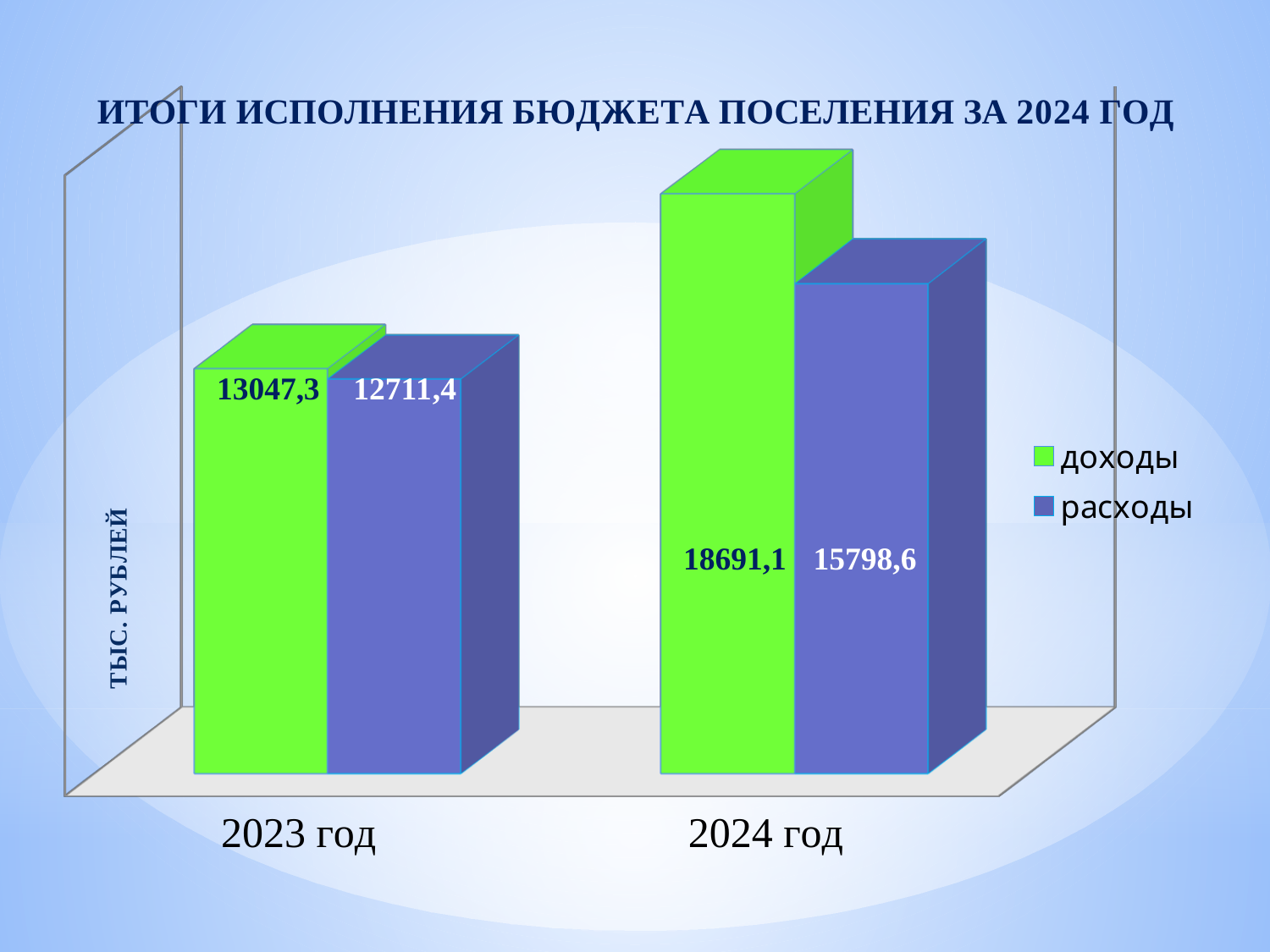
What is the difference between доходы and расходы for 2024 год? 2892,5 How many series does the legend list? 2 What is the value of расходы for 2023 год? 12711,4 What unit is given on the vertical axis label? ТЫС. РУБЛЕЙ What is the value of доходы for 2024 год? 18691,1 By how much did доходы increase from 2023 год to 2024 год? 5643,8 Which bar on the chart has the lowest value? расходы for 2023 год What is the value of доходы for 2023 год? 13047,3 What kind of chart is shown on the slide? bar chart What is the value of расходы for 2024 год? 15798,6 Which year has the higher value of доходы? 2024 год Which is larger for 2024 год, доходы or расходы? доходы